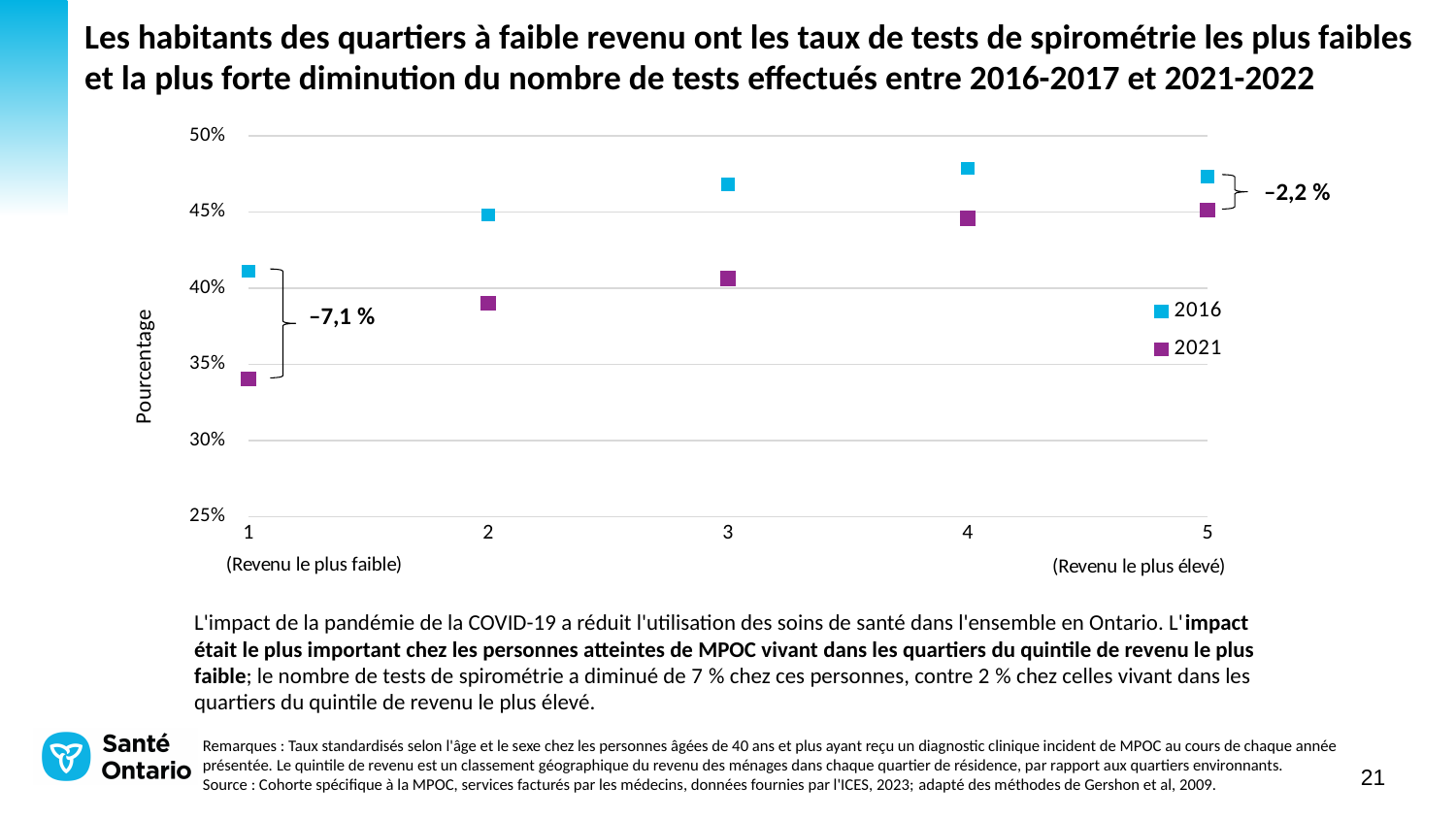
Which quintile has the lowest value for the 2016 series? 1 What change is annotated for quintile 5 (Revenu le plus élevé) between 2016 and 2021? –2,2 % What kind of chart is shown on the slide? Scatter (dot) chart Is the 2016 value for quintile 4 greater or less than 45%? greater What change is annotated for quintile 1 (Revenu le plus faible) between 2016 and 2021? –7,1 % Is the 2021 value for quintile 2 greater or less than 40%? less How many series does the legend list? 2 For quintile 3, which series has the larger value, 2016 or 2021? 2016 Is the 2021 value for quintile 1 greater or less than 35%? less Do the 2021 values rise or fall from quintile 1 to quintile 5? rise Which quintile has the lowest value for the 2021 series? 1 How many income quintiles are plotted along the x axis? 5